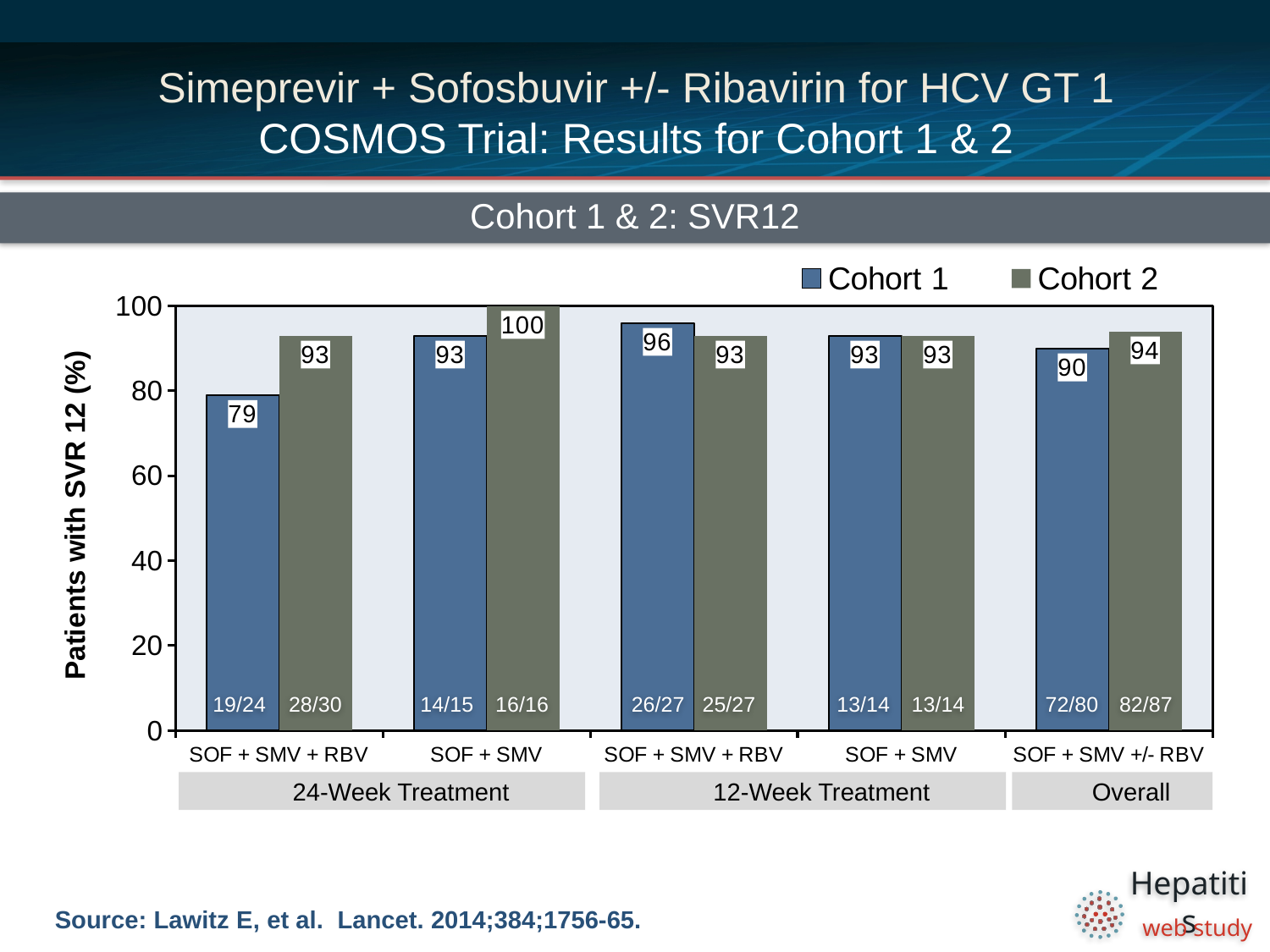
What is the SVR12 value for Cohort 2 in the 24-Week Treatment SOF + SMV group? 100 What is the SVR12 value for Cohort 1 in the 12-Week Treatment SOF + SMV + RBV group? 96 What is the patient fraction shown for Cohort 1 in the Overall group? 72/80 What is the SVR12 value for Cohort 1 in the 24-Week Treatment SOF + SMV + RBV group? 79 Which bar has the lowest SVR12 value on the chart? Cohort 1, 24-Week Treatment SOF + SMV + RBV How many series does the legend list? 2 What is the Overall SVR12 value for Cohort 2 (SOF + SMV +/- RBV)? 94 What type of chart is shown on the slide? Bar chart What is the y-axis label of the chart? Patients with SVR 12 (%) Which bar has the highest SVR12 value on the chart? Cohort 2, 24-Week Treatment SOF + SMV In the 12-Week Treatment SOF + SMV + RBV group, which cohort has the higher SVR12 value? Cohort 1 What is the difference between the Cohort 2 and Cohort 1 SVR12 values in the 24-Week Treatment SOF + SMV + RBV group? 14